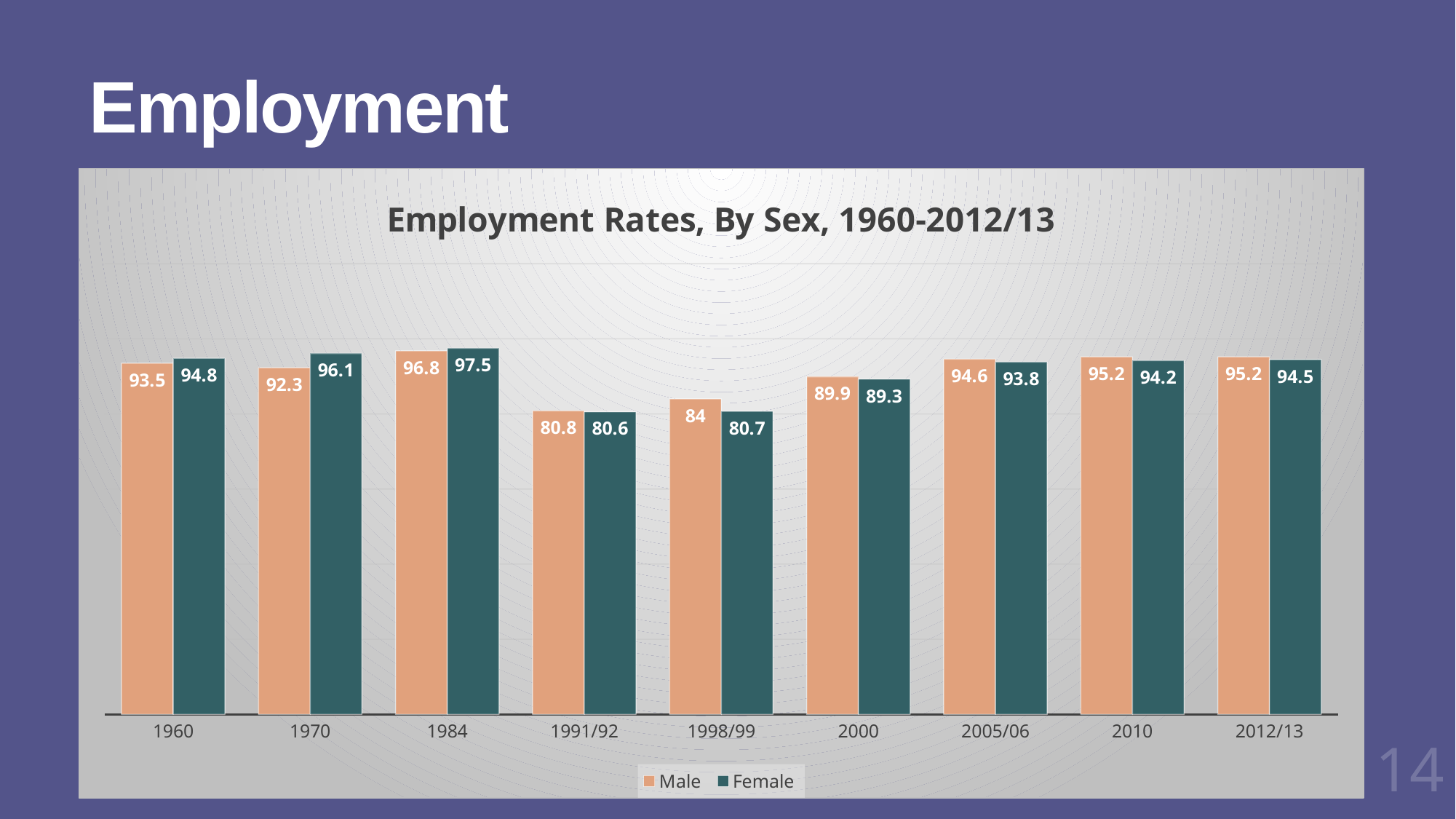
How many years are shown on the x axis? 9 What is the difference between the Female and Male employment rates in 1970? 3.8 Do the Male employment rates rise or fall from 1991/92 to 2010? Rise Which year has the highest Female employment rate? 1984 What is the title of the chart? Employment Rates, By Sex, 1960-2012/13 What is the Male employment rate for 2000? 89.9 What is the Male employment rate for 1984? 96.8 What is the Female employment rate for 1998/99? 80.7 What kind of chart is shown on the slide? Bar chart Which year has the lowest Male employment rate? 1991/92 Which is larger in 2005/06, the Male or the Female employment rate? Male How many series does the legend list? 2